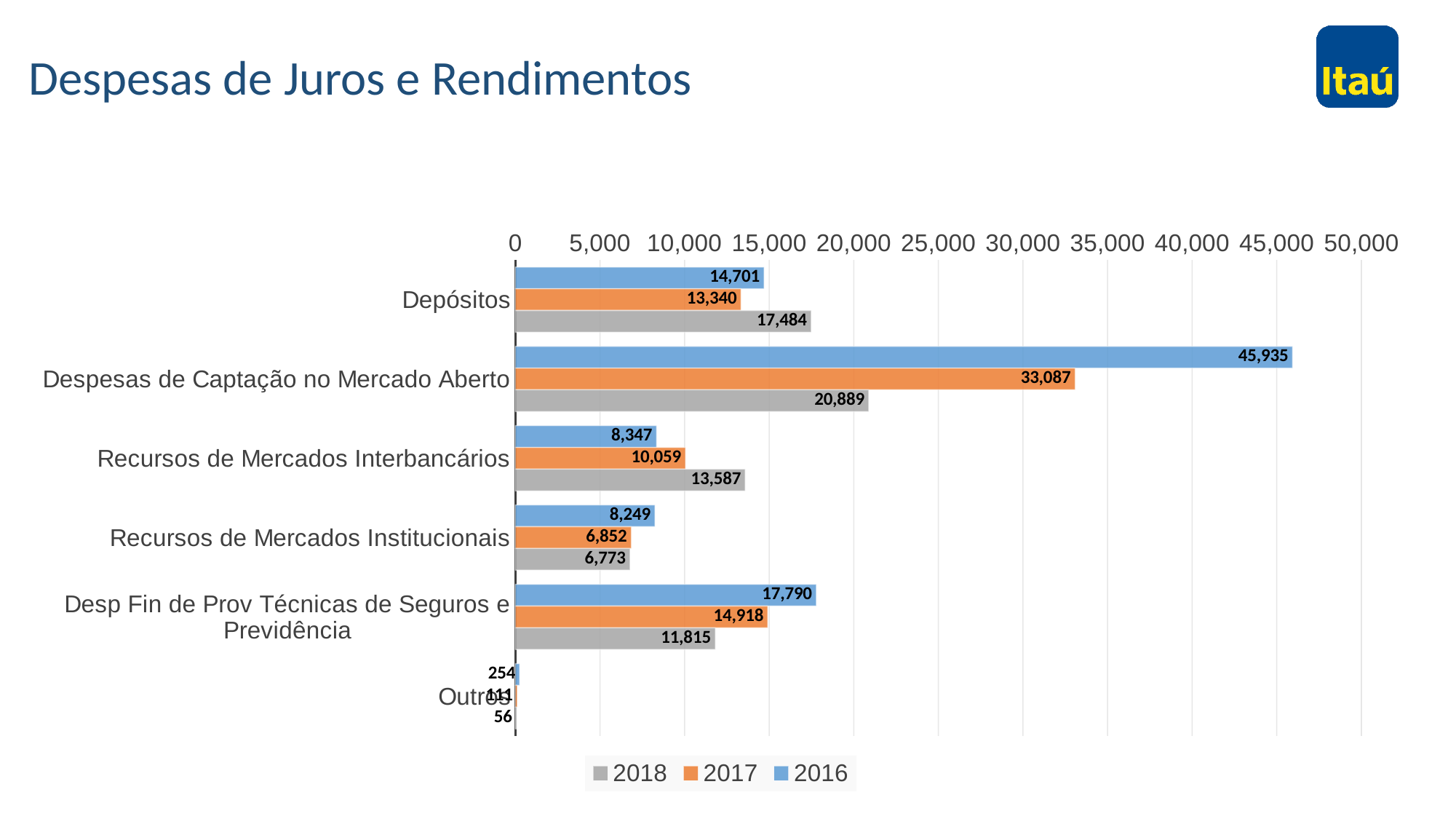
How many categories are shown on the chart? 6 What is the 2017 value for Recursos de Mercados Interbancários? 10,059 What type of chart is shown on the slide? bar chart Which colour represents the 2017 series in the legend? orange What is the 2016 value for Despesas de Captação no Mercado Aberto? 45,935 What is the 2018 value for Depósitos? 17,484 What is the difference between the 2016 and 2018 values for Despesas de Captação no Mercado Aberto? 25,046 Is the 2017 value for Despesas de Captação no Mercado Aberto greater or less than 30,000? greater Which category has the highest 2016 value? Despesas de Captação no Mercado Aberto How many series does the legend list? 3 Which category has the lowest 2018 value? Outros Which is larger for Desp Fin de Prov Técnicas de Seguros e Previdência: the 2016 value or the 2018 value? 2016